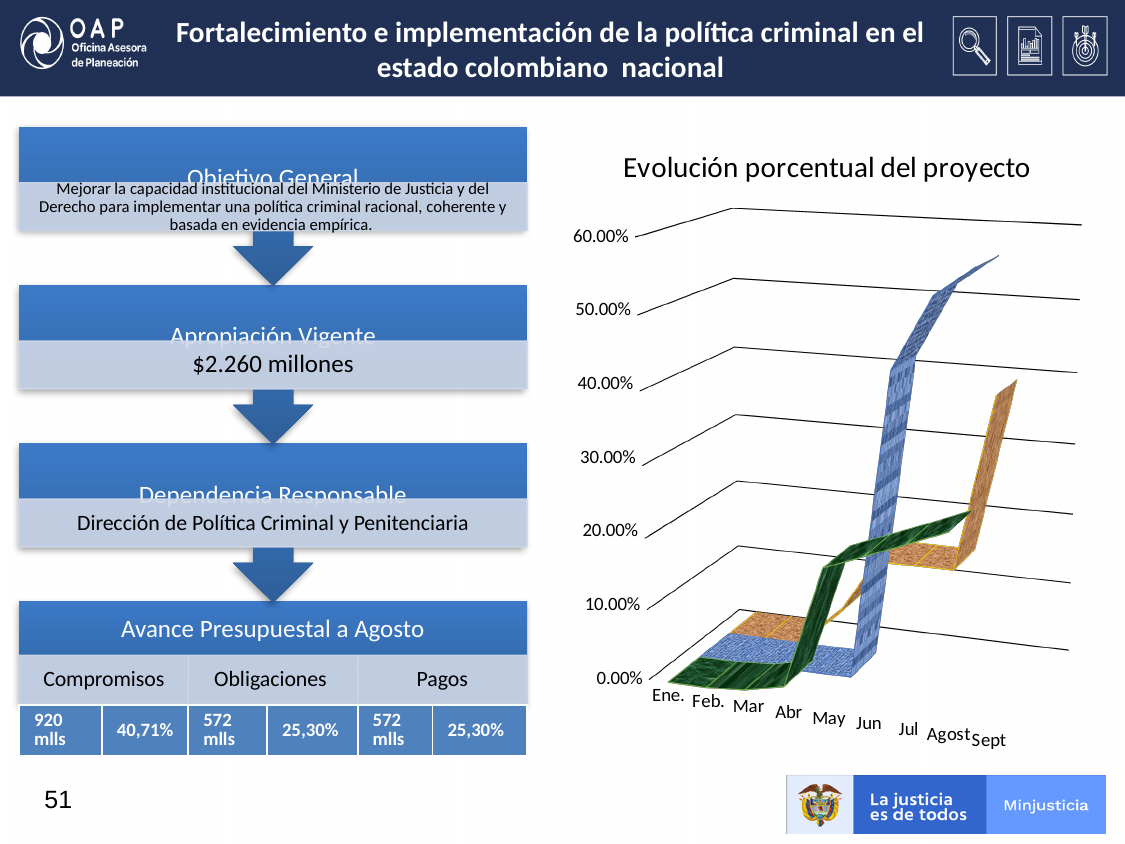
How many months are shown along the x axis of the chart? 9 What kind of chart is used to show the 'Evolución porcentual del proyecto'? line chart What is the last month label on the x axis of the chart? Sept What is the highest value shown on the vertical axis of the chart? 60.00% What is the title of the chart on the right side of the slide? Evolución porcentual del proyecto What is the first month label on the x axis of the chart? Ene. Do the values in the chart generally rise or fall from Ene. to Sept? rise